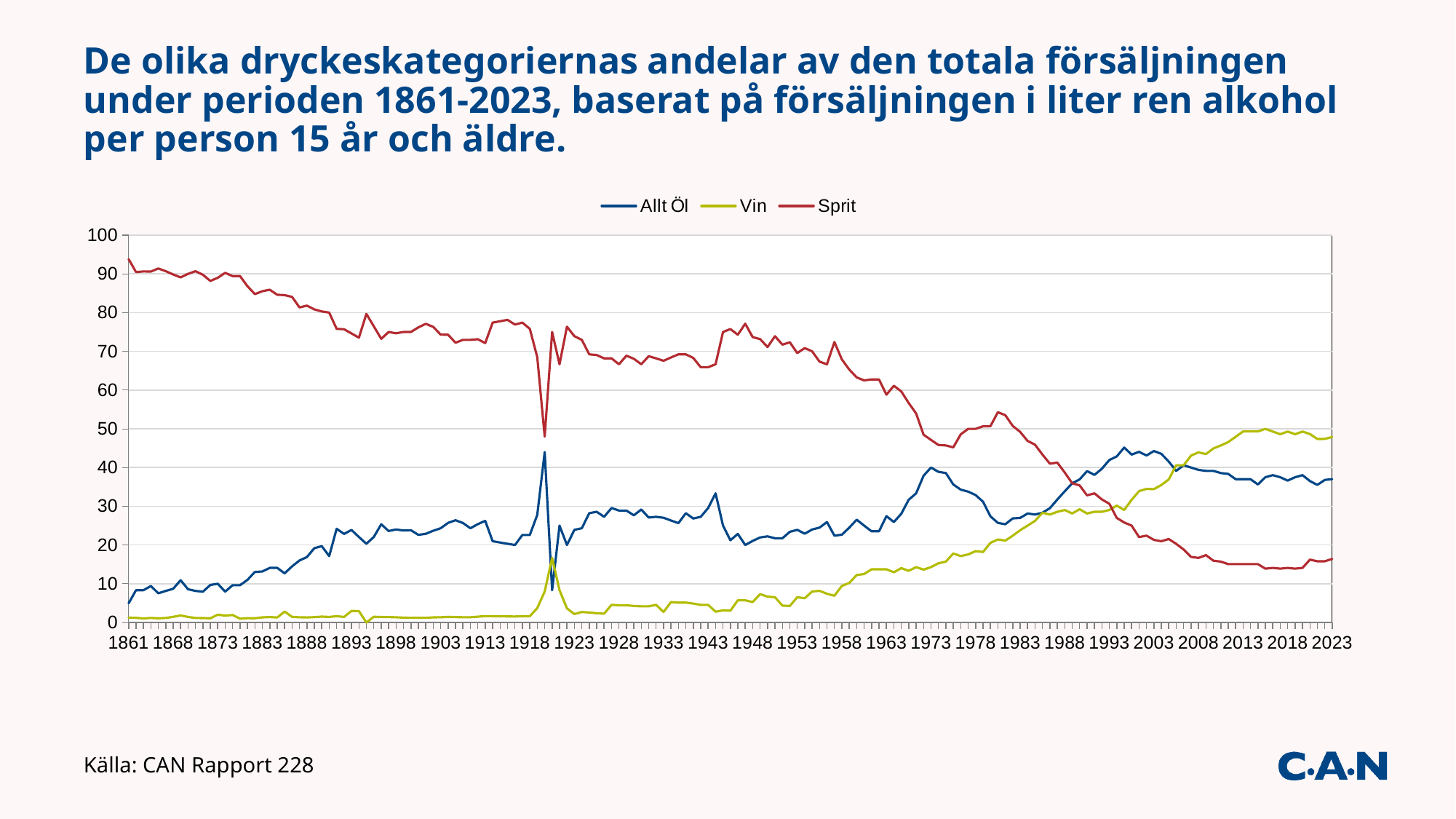
In 2023, which is larger: Vin or Allt Öl? Vin How many series does the legend list? 3 Which series are listed in the legend? Allt Öl, Vin, Sprit Is the value for Sprit in 2023 greater or less than 20? less What kind of chart is shown on the slide? Line chart Does the Vin series rise or fall overall from 1861 to 2023? Rise Is the value for Sprit in 1861 greater or less than 90? greater Is the value for Allt Öl in 1861 greater or less than 10? less Does the Sprit series rise or fall overall from 1861 to 2023? Fall Which series has the lowest value in 1861? Vin Which series has the highest value in 1861? Sprit